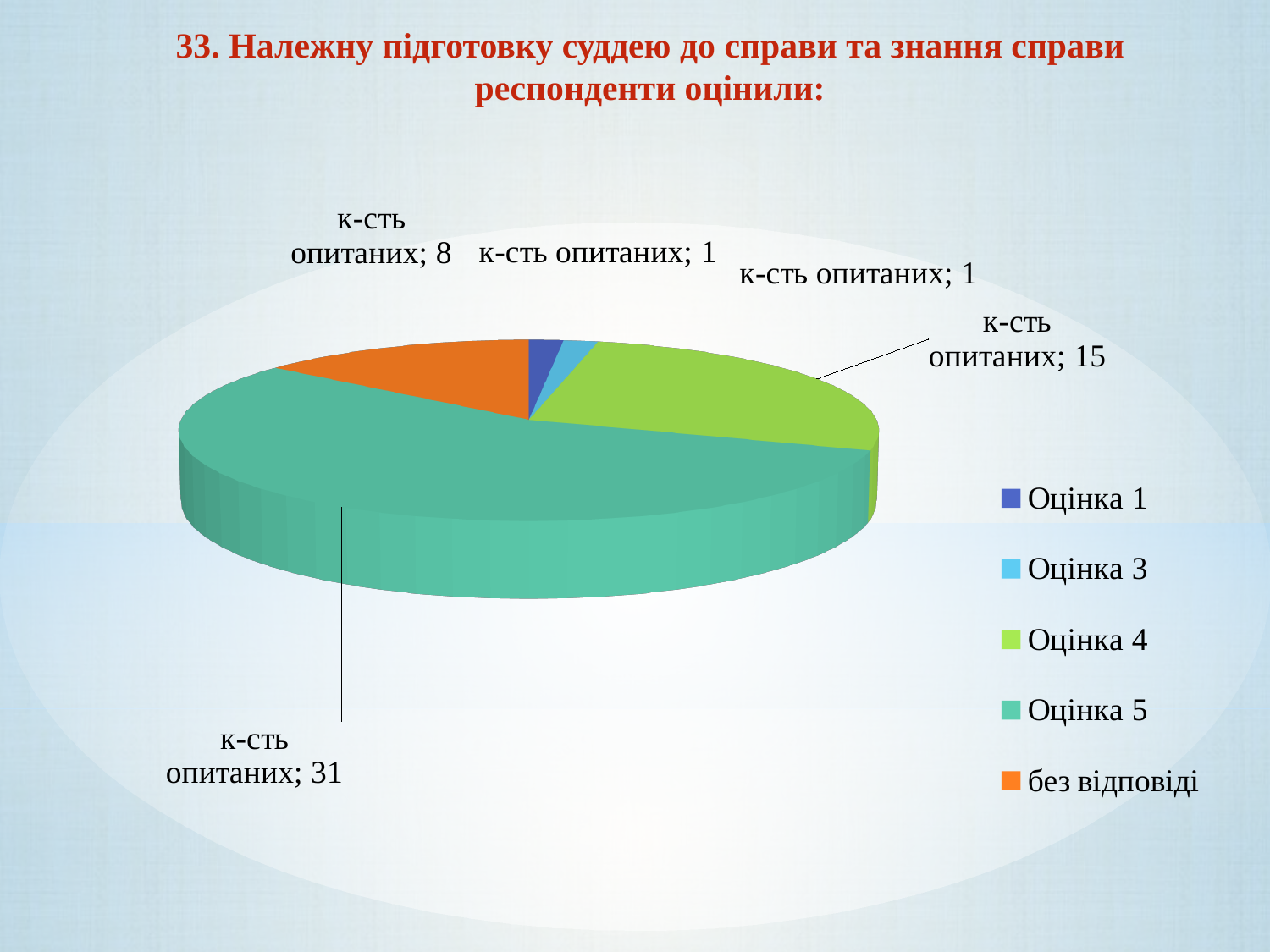
What colour is the slice for 'без відповіді'? orange How many respondents gave Оцінка 1? 1 How many respondents gave Оцінка 4? 15 What is the difference between the number of respondents for Оцінка 5 and Оцінка 4? 16 Which is larger: the value for Оцінка 4 or the value for 'без відповіді'? Оцінка 4 How many respondents gave Оцінка 5? 31 How many categories does the legend list? 5 How many respondents are in the 'без відповіді' category? 8 What is the total number of respondents across all slices? 56 What kind of chart is shown on the slide? pie chart Which category has the largest slice of the pie? Оцінка 5